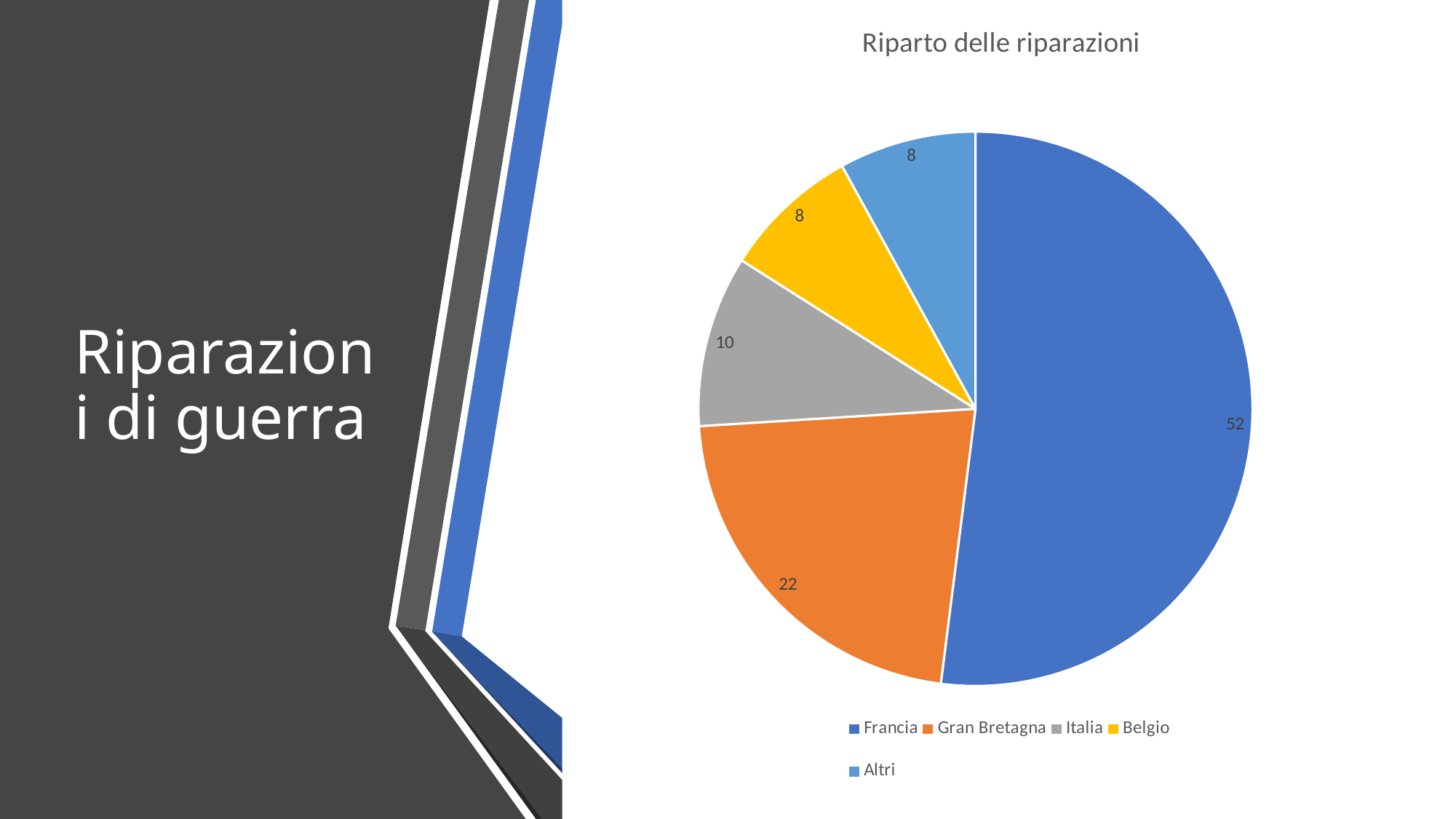
What is the value for Italia in the pie chart? 10 Which category has the largest slice of the pie chart? Francia How many slices does the pie chart have? 5 Which is larger, the value for Italia or the value for Belgio? Italia What is the value for Belgio in the pie chart? 8 What share of the pie does Francia represent? 52% What is the difference between the values for Francia and Gran Bretagna? 30 What is the value for Gran Bretagna in the pie chart? 22 What is the value for Francia in the pie chart? 52 What is the title of the chart? Riparto delle riparazioni What is the total of all the values shown in the pie chart? 100 What kind of chart is shown on the slide? Pie chart